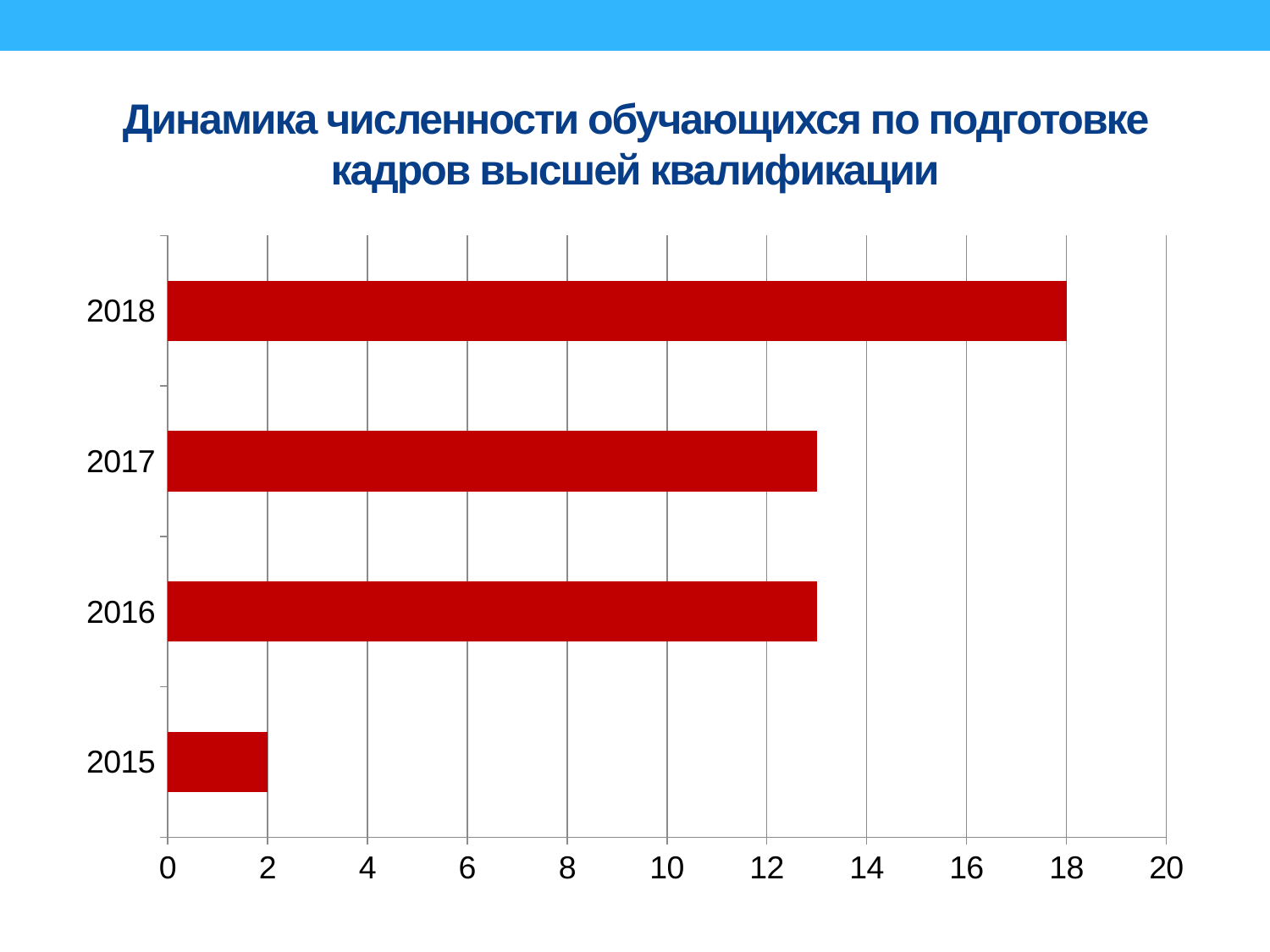
Which year has the lowest value? 2015 What is the value for 2018? 18 What is the difference between the values for 2018 and 2015? 16 What is the value for 2015? 2 Is the value for 2016 greater or less than 14? less Which is larger, the value for 2018 or the value for 2017? 2018 How many years are shown in the chart? 4 What type of chart is shown on the slide? bar chart Which year has the highest value? 2018 Is the value for 2017 greater or less than 12? greater What is the title of the slide? Динамика численности обучающихся по подготовке кадров высшей квалификации Do the values rise or fall from 2015 to 2018? rise